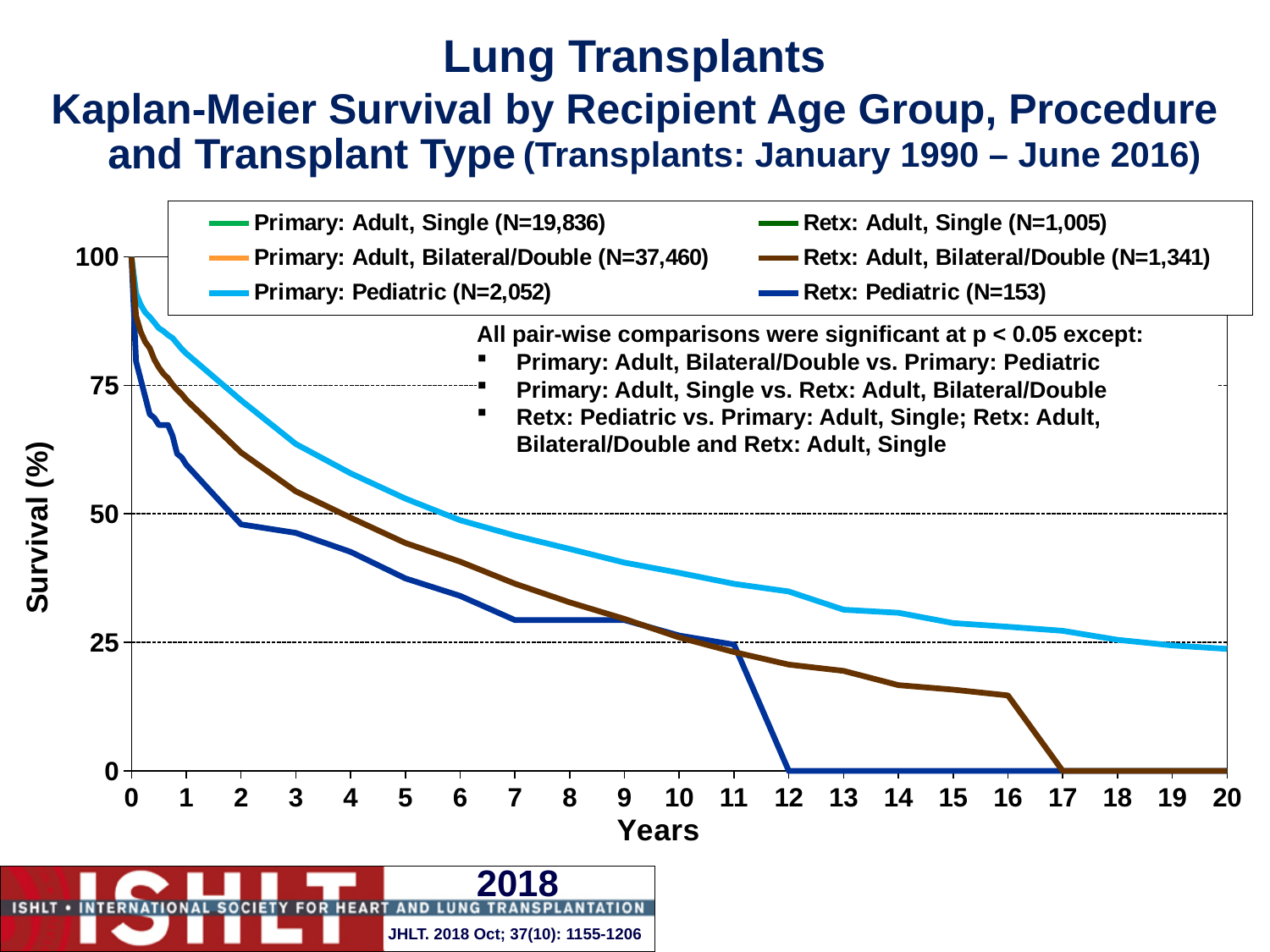
What is the N shown in the legend for Primary: Adult, Bilateral/Double? 37,460 What is the survival value for Retx: Pediatric at year 12? 0 Do the survival curves rise or fall as the years increase? Fall At year 10, which is higher: Primary: Pediatric or Retx: Adult, Bilateral/Double? Primary: Pediatric What is the survival value for Primary: Pediatric at year 0? 100 Is the survival value for Primary: Pediatric at year 10 greater or less than 25? greater Is the survival value for Retx: Adult, Bilateral/Double at year 15 greater or less than 25? less What is the survival value for Retx: Adult, Bilateral/Double at year 17? 0 How many series does the legend list? 6 Is the survival value for Retx: Pediatric at year 5 greater or less than 50? less What kind of chart is shown on the slide? Line chart What is the label of the y axis? Survival (%)